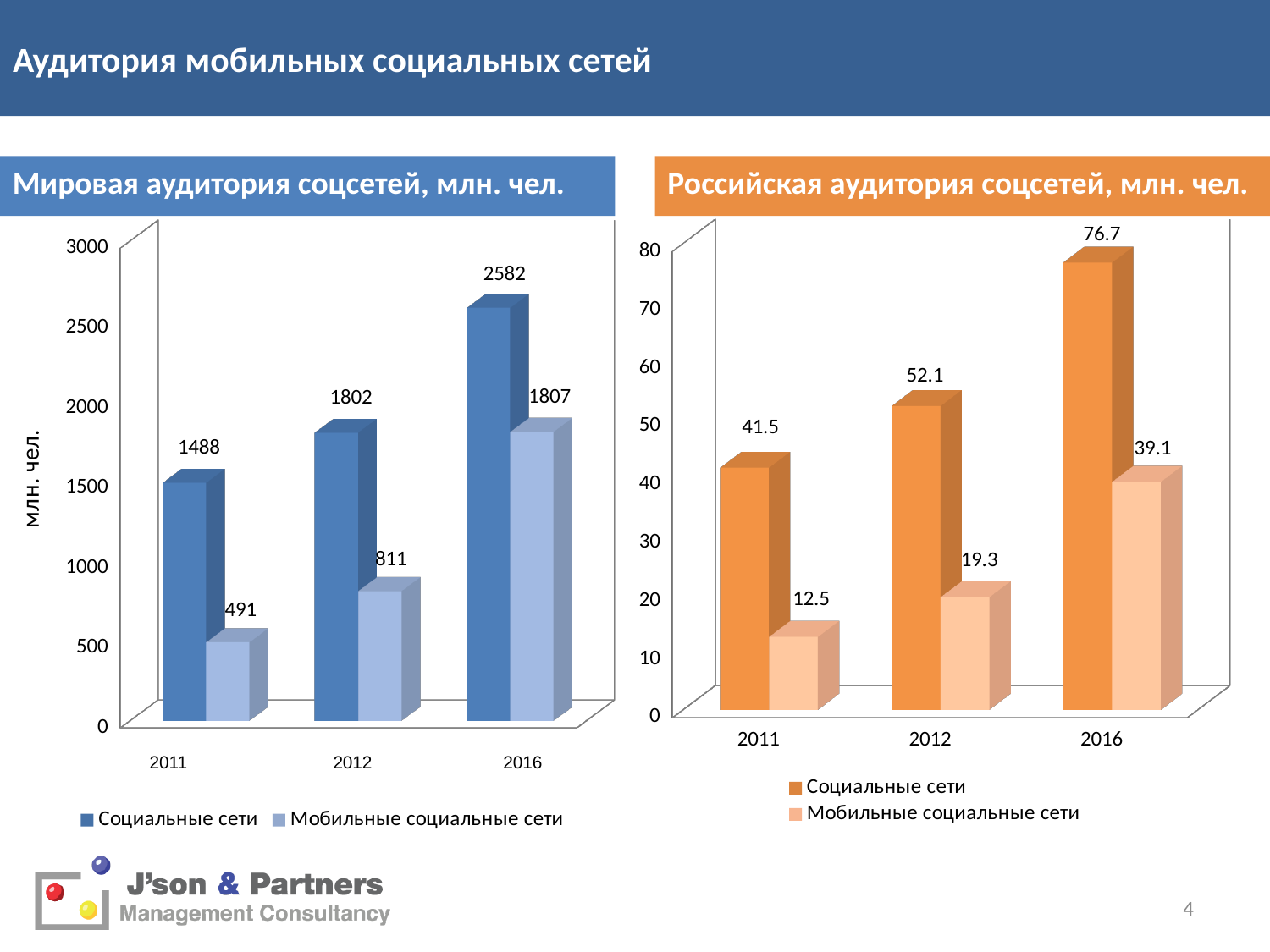
In the chart 'Мировая аудитория соцсетей, млн. чел.', what is the value for Социальные сети in 2016? 2582 In the chart 'Российская аудитория соцсетей, млн. чел.', what is the value for Мобильные социальные сети in 2016? 39.1 In the chart 'Российская аудитория соцсетей, млн. чел.', which is larger: Мобильные социальные сети in 2012 or Мобильные социальные сети in 2016? 2016 In the chart 'Мировая аудитория соцсетей, млн. чел.', what is the difference between Социальные сети and Мобильные социальные сети in 2012? 991 What kind of chart is 'Мировая аудитория соцсетей, млн. чел.'? bar chart In the chart 'Мировая аудитория соцсетей, млн. чел.', what is the value for Мобильные социальные сети in 2011? 491 In the chart 'Мировая аудитория соцсетей, млн. чел.', do the values for Социальные сети rise or fall from 2011 to 2016? rise In the chart 'Российская аудитория соцсетей, млн. чел.', which year has the highest value for Социальные сети? 2016 In the chart 'Российская аудитория соцсетей, млн. чел.', what is the difference between Социальные сети and Мобильные социальные сети in 2011? 29.0 In the chart 'Российская аудитория соцсетей, млн. чел.', what is the value for Социальные сети in 2012? 52.1 How many series does the legend of the chart 'Российская аудитория соцсетей, млн. чел.' list? 2 In the chart 'Мировая аудитория соцсетей, млн. чел.', which year has the lowest value for Мобильные социальные сети? 2011